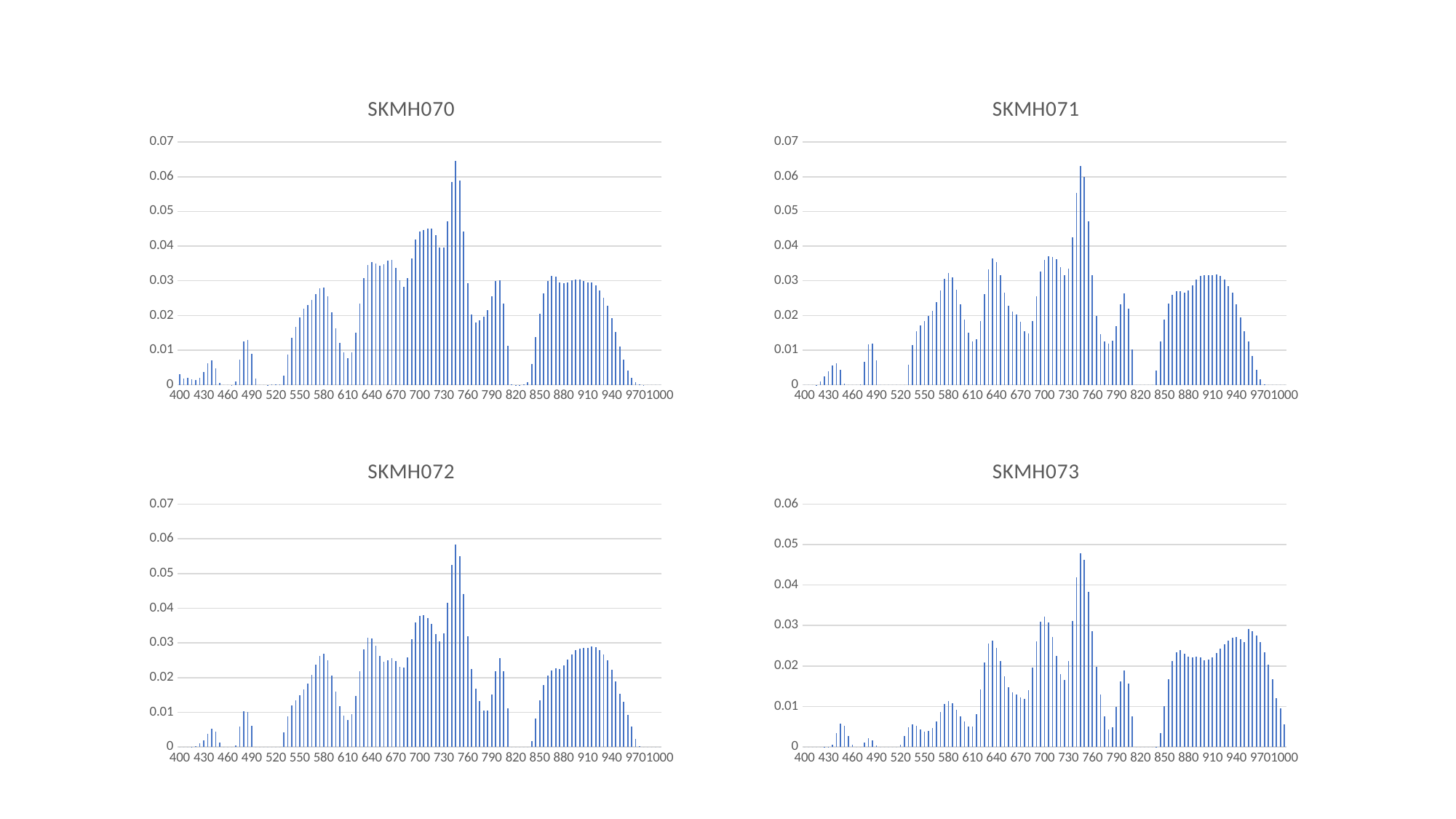
What is the title of the chart in the bottom-right position of the slide? SKMH073 Which chart has the higher tallest bar, SKMH070 or SKMH073? SKMH070 In the SKMH073 chart, is the tallest bar (near 750) greater or less than 0.04? greater What kind of chart is SKMH070? bar chart In the SKMH070 chart, is the tallest bar (near 750) greater or less than 0.06? greater In the SKMH073 chart, is the value at 1000 greater or less than 0.01? less How many charts are shown on the slide? 4 What is the highest value shown on the y axis of the SKMH073 chart? 0.06